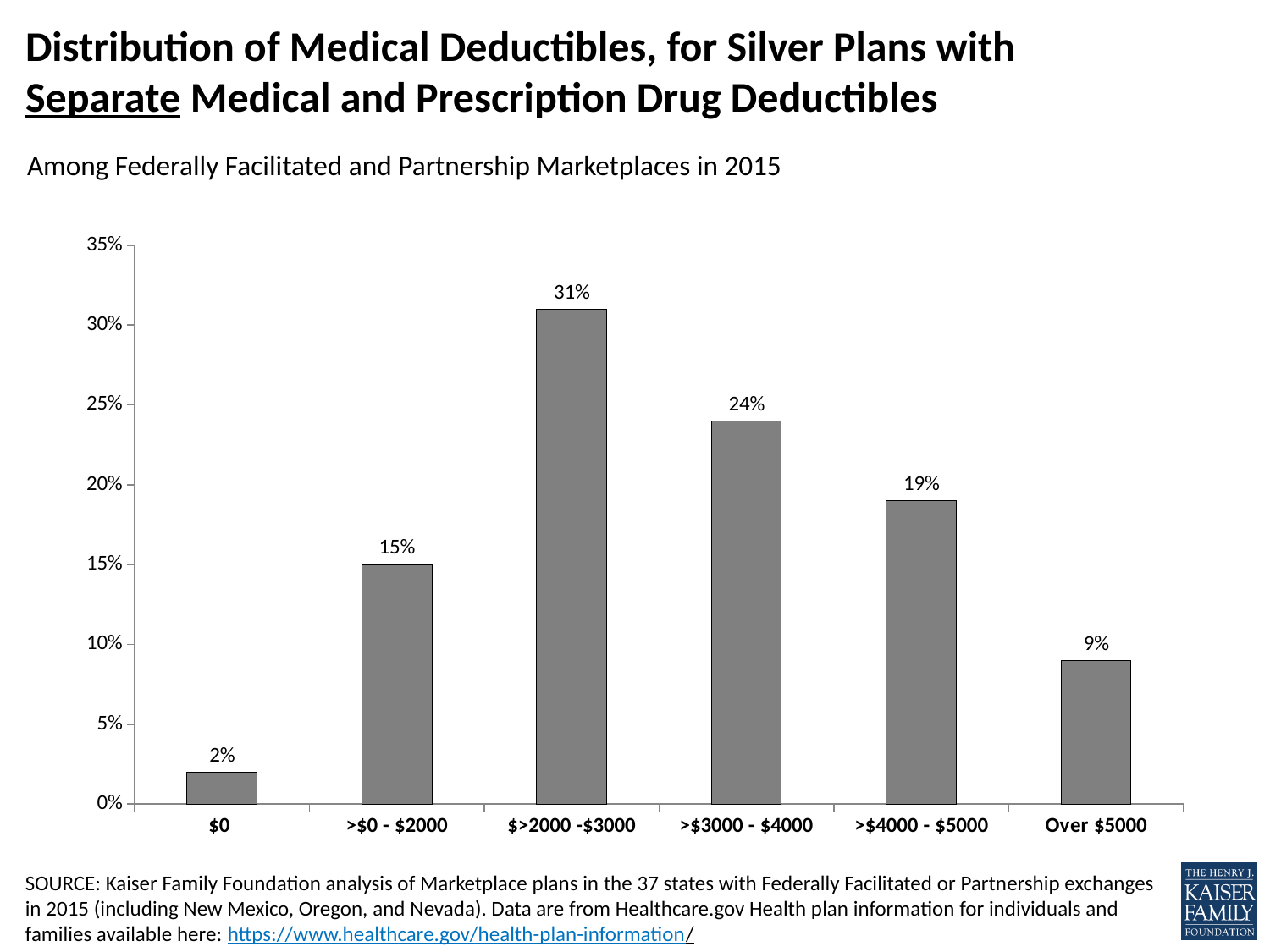
How many deductible categories are shown on the x axis? 6 What is the subtitle shown below the chart title? Among Federally Facilitated and Partnership Marketplaces in 2015 What percentage of silver plans have a medical deductible of $>2000 -$3000? 31% Which category has a larger share: >$0 - $2000 or Over $5000? >$0 - $2000 What is the difference in percentage points between the >$3000 - $4000 and >$4000 - $5000 categories? 5% Which deductible range has the highest share of plans? $>2000 -$3000 What percentage of silver plans have a medical deductible of Over $5000? 9% Is the value for >$3000 - $4000 greater or less than 20%? greater What kind of chart is shown on the slide? Bar chart What percentage of silver plans have a medical deductible of $0? 2% Do the values rise or fall from the $>2000 -$3000 category to the Over $5000 category? Fall Which deductible range has the lowest share of plans? $0